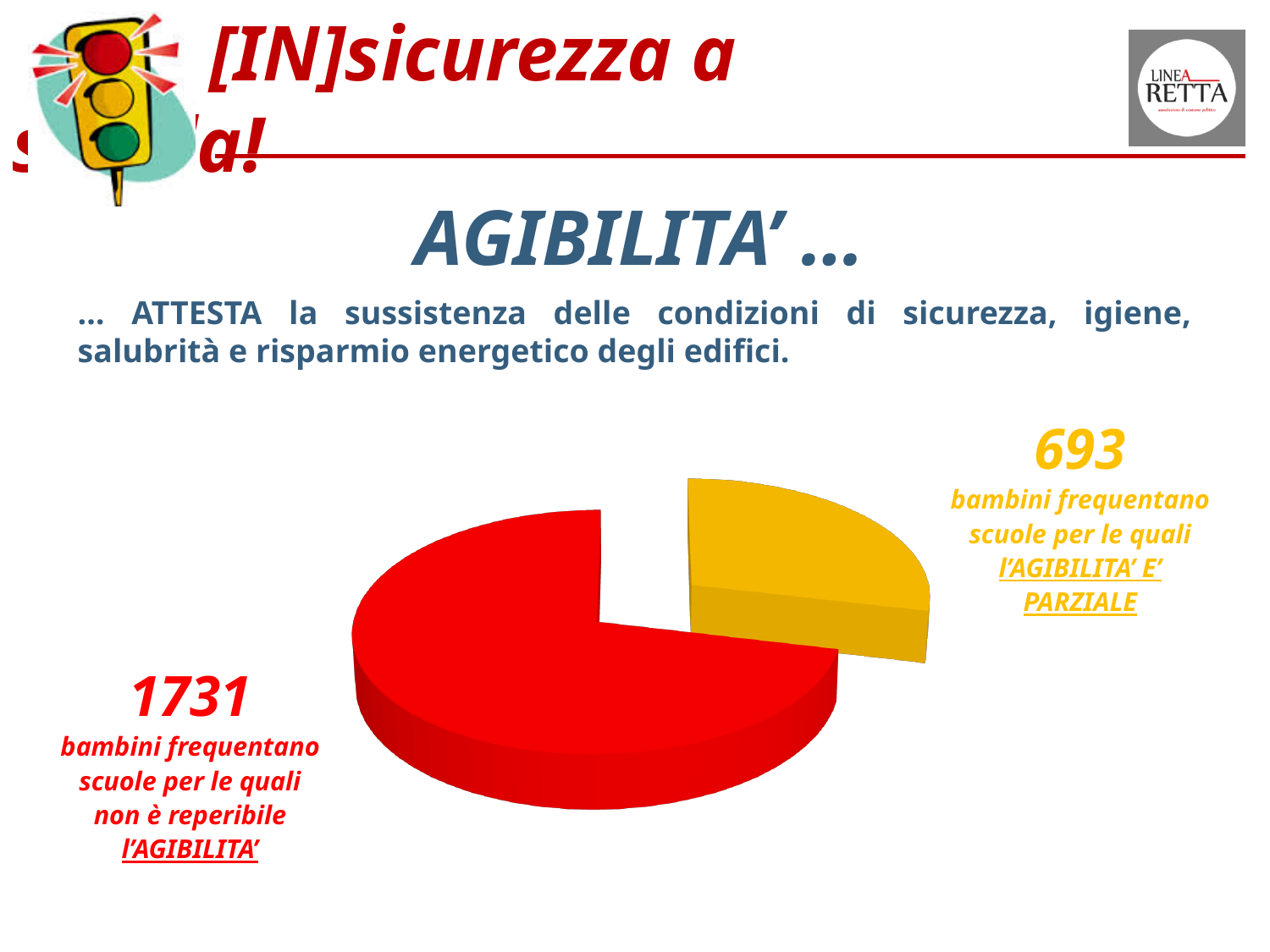
What kind of chart is shown on the slide? pie chart Which group of children is the smallest in the pie chart? bambini frequentano scuole per le quali l'agibilità è parziale (693) What is the total number of children represented in the pie chart? 2424 Which is larger: the number of children in schools with no available agibilità or the number in schools with partial agibilità? schools with no available agibilità (1731) What colour is the slice representing children in schools with partial agibilità? yellow Which group of children is the largest in the pie chart? bambini frequentano scuole per le quali non è reperibile l'agibilità (1731) How many slices does the pie chart have? 2 What is the difference between the number of children in schools with no available agibilità and those in schools with partial agibilità? 1038 What colour is the slice representing the 1731 children? red How many children attend schools for which the agibilità is partial (parziale)? 693 How many children attend schools for which the agibilità is not available (non è reperibile)? 1731